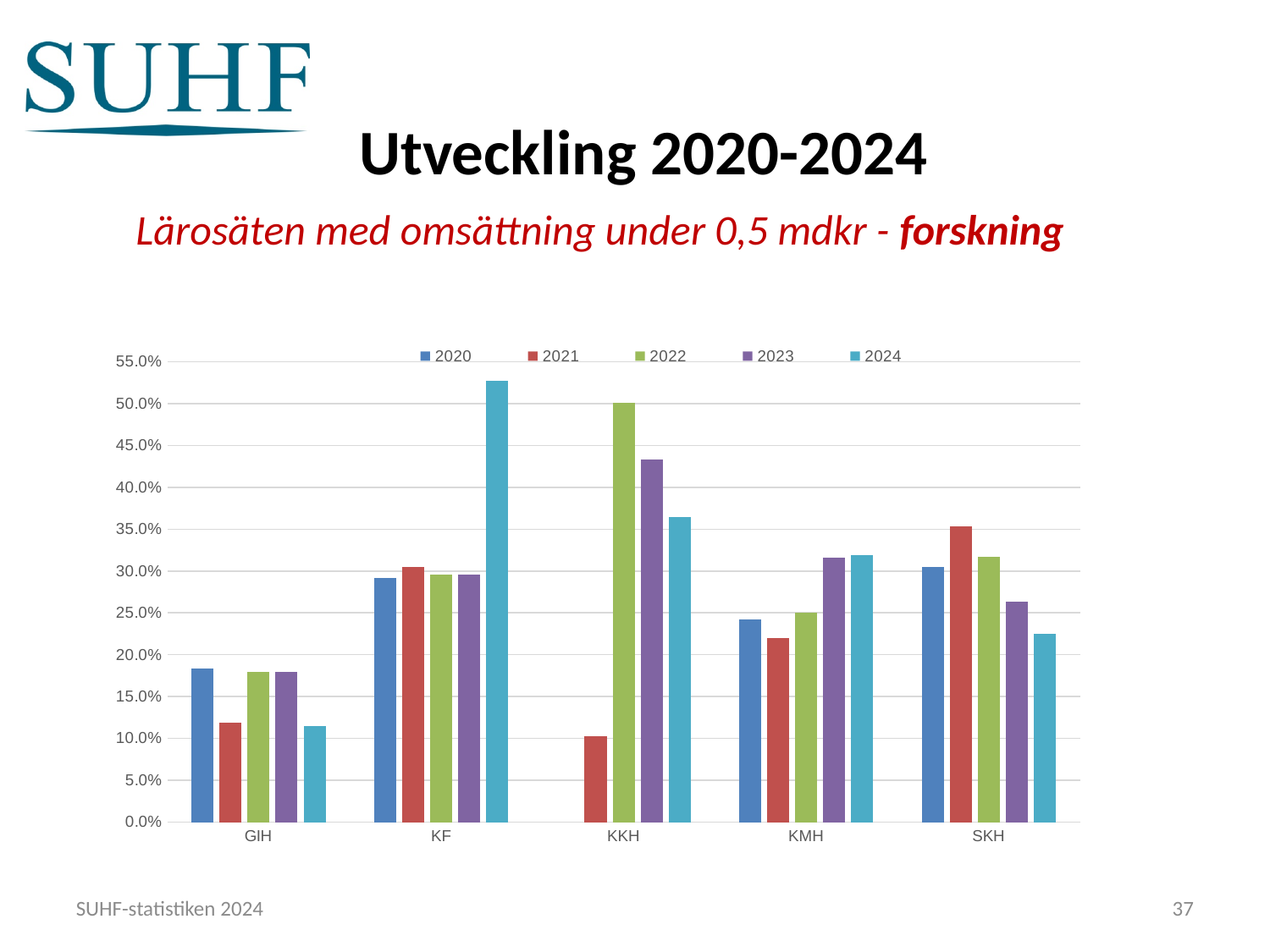
How many series does the legend list? 5 Which institution has no bar for 2020? KKH For KKH, which year has the larger value, 2022 or 2023? 2022 Which institution has the lowest value for 2024? GIH Is the 2024 value for KF greater or less than 50.0%? greater How many institutions (categories) are shown on the x axis? 5 Is the 2023 value for KMH greater or less than 30.0%? greater Is the 2021 value for KKH greater or less than 15.0%? less Which institution has the highest value for 2024? KF Which institution has the highest value for 2022? KKH For SKH, do the values rise or fall from 2021 to 2024? fall What kind of chart is shown on the slide? bar chart